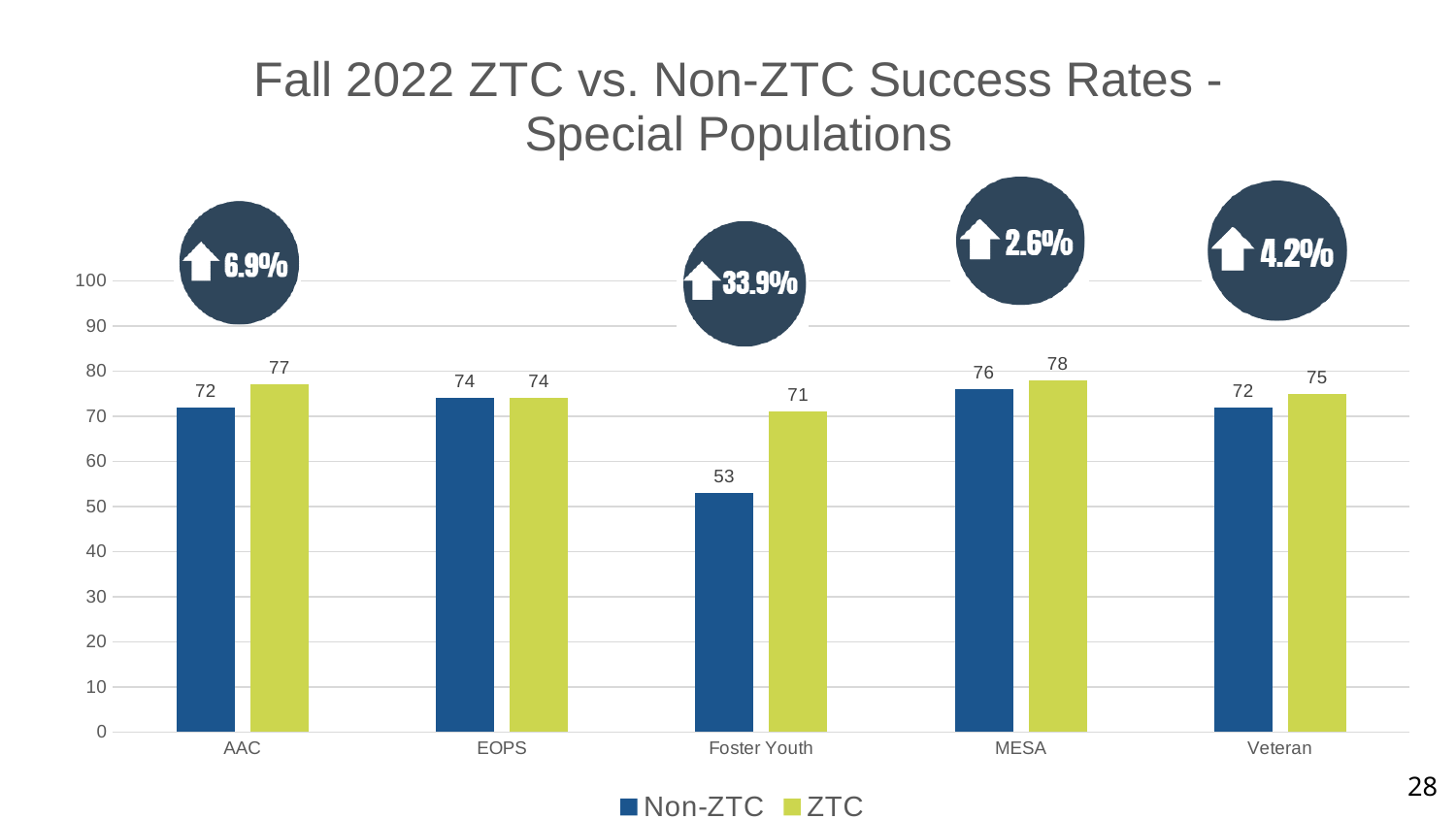
What percentage increase is shown in the circle above Foster Youth? 33.9% Which category has the highest ZTC value? MESA What is the Non-ZTC success rate for Foster Youth? 53 What is the difference between the ZTC and Non-ZTC values for Foster Youth? 18 How many series does the legend list? 2 Which is larger for AAC, the Non-ZTC value or the ZTC value? ZTC What is the ZTC success rate for MESA? 78 What kind of chart is shown on the slide? Bar chart What is the ZTC value for AAC? 77 How many categories are shown on the x axis? 5 Which category has the lowest Non-ZTC value? Foster Youth What is the difference between the ZTC and Non-ZTC values for Veteran? 3